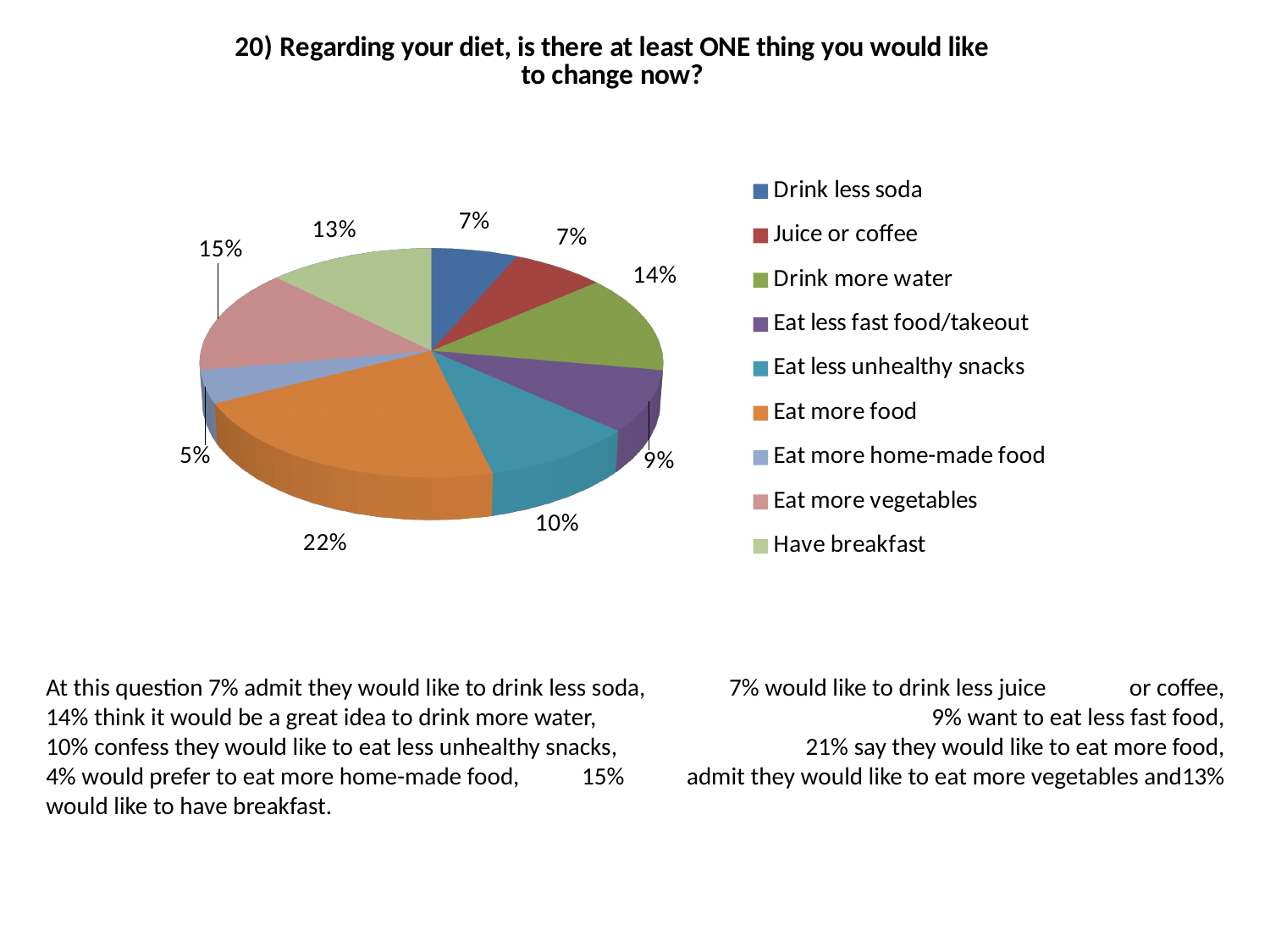
What percentage is shown for "Eat less unhealthy snacks" in the pie chart? 10% What percentage is shown for "Eat less fast food/takeout" in the pie chart? 9% How many categories does the legend of the pie chart list? 9 Which category has the smallest slice in the pie chart? Eat more home-made food What colour is the "Eat more food" slice in the pie chart? Orange What is the difference in percentage points between "Eat more food" and "Have breakfast" in the pie chart? 9 Which is larger in the pie chart, "Eat more vegetables" or "Drink more water"? Eat more vegetables What percentage is shown for "Drink more water" in the pie chart? 14% Which category has the largest slice in the pie chart? Eat more food What percentage of the pie chart is labelled for "Eat more food"? 22% What kind of chart is shown on the slide? Pie chart What percentage is shown for "Eat more vegetables" in the pie chart? 15%